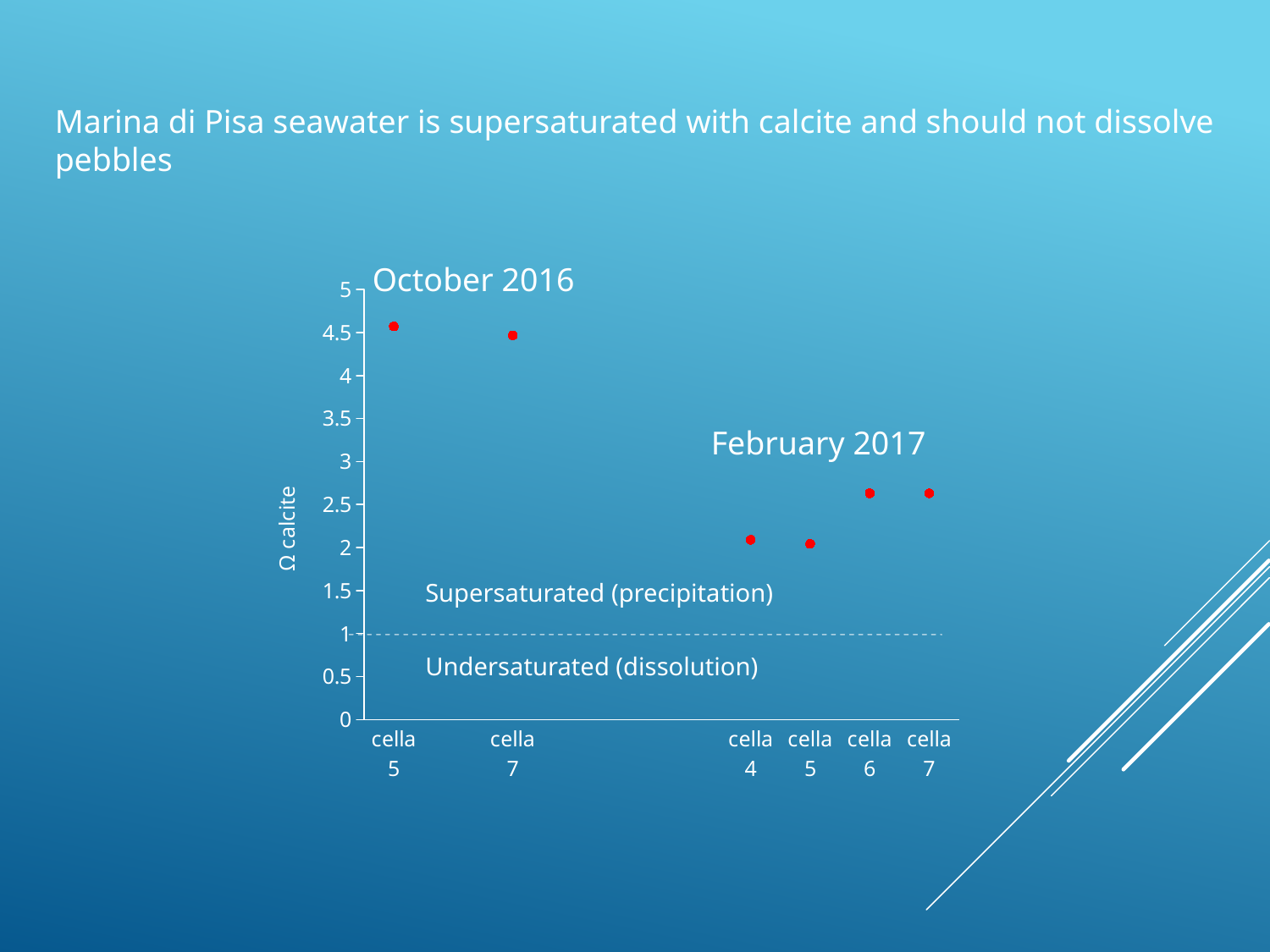
Is the value for cella 5 in February 2017 greater or less than 1? greater Is the value for cella 6 in February 2017 greater or less than 2.5? greater How many data points are plotted on the chart? 6 Which point has the highest Ω calcite value? cella 5, October 2016 What is the label of the y axis? Ω calcite Which is larger, the value for cella 5 in October 2016 or the value for cella 4 in February 2017? cella 5 in October 2016 At what y-axis value is the dashed horizontal line separating supersaturated from undersaturated drawn? 1 Is the value for cella 7 in October 2016 greater or less than 4? greater What kind of chart is shown on the slide? Scatter chart Do the Ω calcite values rise or fall from October 2016 to February 2017? fall